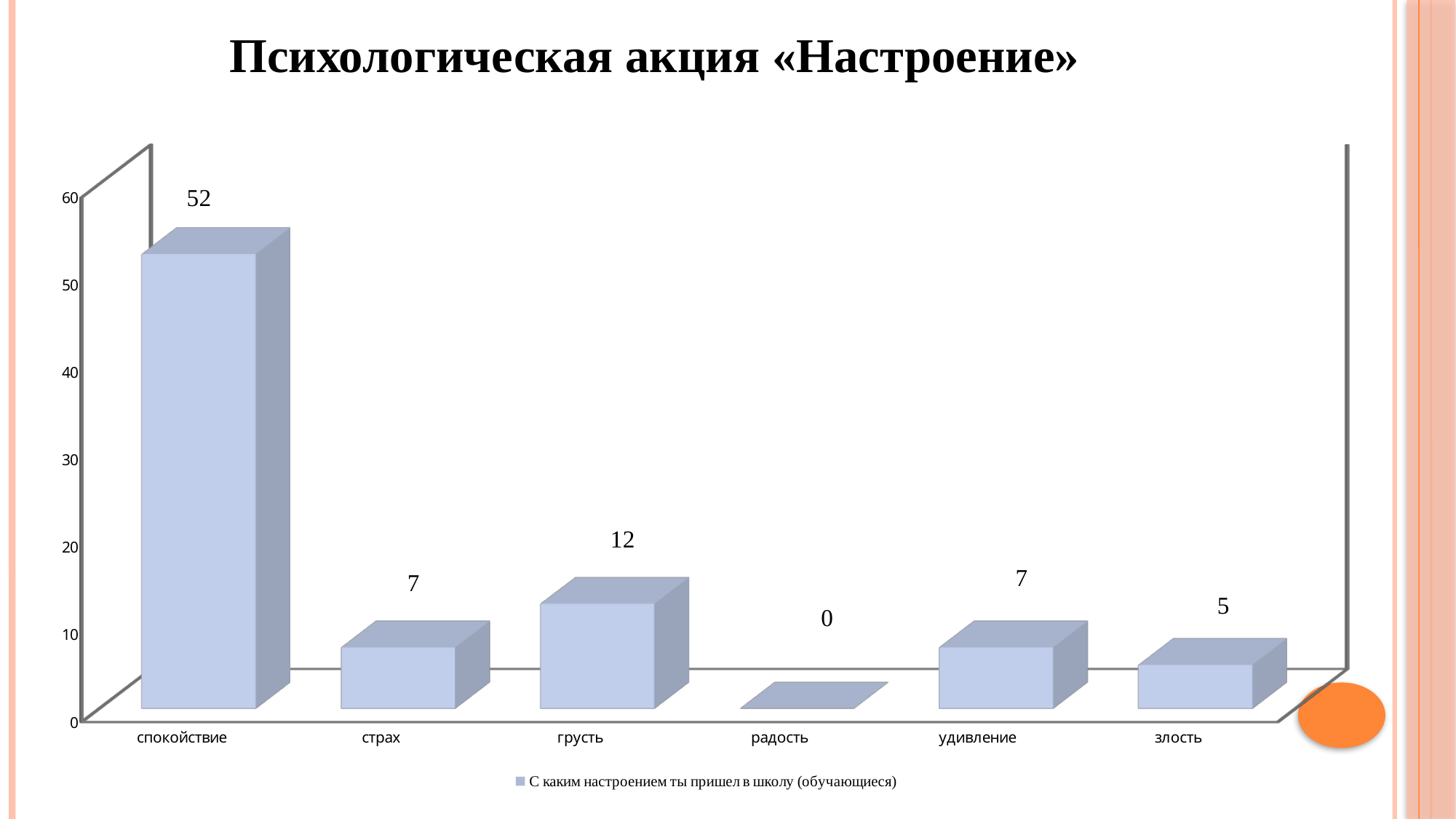
Which category has the highest value? спокойствие What is the value for злость? 5 What is the difference between the values for спокойствие and грусть? 40 What is the title of the slide? Психологическая акция «Настроение» Is the value for спокойствие greater or less than 50? greater Which is larger, the value for страх or the value for грусть? грусть How many categories are shown on the x axis? 6 Which category has the lowest value? радость What is the value for радость? 0 What is the value for грусть? 12 What is the value for спокойствие? 52 What kind of chart is shown on the slide? bar chart